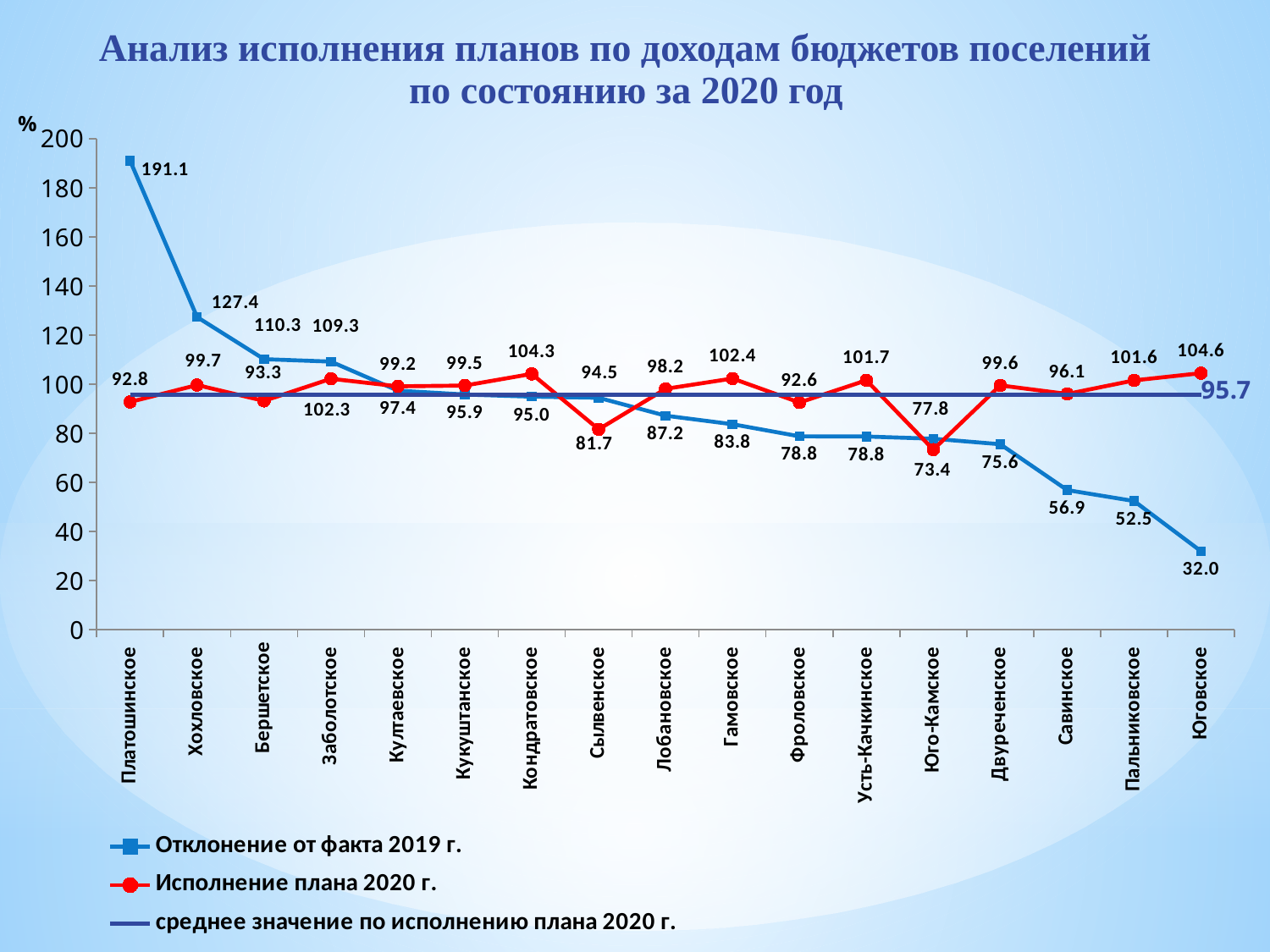
What is the value of the 'Исполнение плана 2020 г.' series for Кондратовское? 104.3 What is the value of the 'Исполнение плана 2020 г.' series for Юго-Камское? 73.4 What kind of chart is shown on the slide? Line chart What is the value of the 'Отклонение от факта 2019 г.' series for Платошинское? 191.1 How many settlements are shown on the x axis? 17 Which settlement has the highest value in the 'Исполнение плана 2020 г.' series? Юговское What is the value of the average line 'среднее значение по исполнению плана 2020 г.'? 95.7 For Сылвенское, which series has the larger value: 'Отклонение от факта 2019 г.' or 'Исполнение плана 2020 г.'? Отклонение от факта 2019 г. How many series does the legend list? 3 Which settlement has the lowest value in the 'Отклонение от факта 2019 г.' series? Юговское Does the 'Отклонение от факта 2019 г.' series rise or fall from left to right along the x axis? Fall What is the difference between the 'Отклонение от факта 2019 г.' value and the 'Исполнение плана 2020 г.' value for Платошинское? 98.3